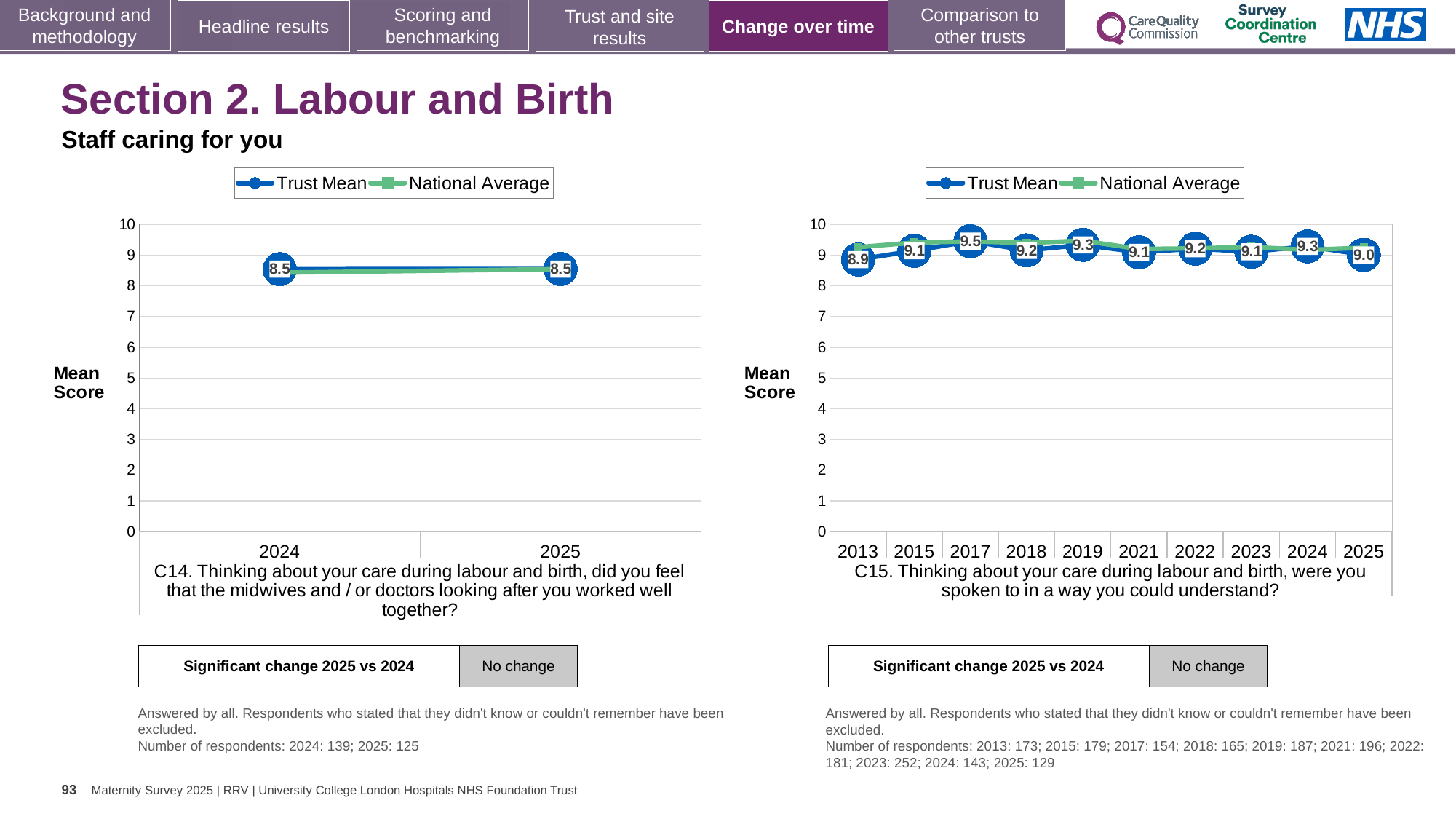
In the right chart (C15), what is the difference between the Trust Mean scores for 2017 and 2013? 0.6 In the right chart (C15), is the Trust Mean score for 2019 larger or smaller than the score for 2021? larger In the left chart (C14), what is the Trust Mean score for 2025? 8.5 In the left chart (C14), is the National Average value for 2025 greater or less than 8? greater In the right chart (C15), which year has the lowest Trust Mean score? 2013 In the right chart (C15), what is the Trust Mean score for 2025? 9.0 How many years are shown on the x axis of the right chart (C15)? 10 In the right chart (C15), which year has the highest Trust Mean score? 2017 How many series does the legend of the left chart (C14) list? 2 What type of chart is the right chart (C15)? Line chart In the right chart (C15), what is the Trust Mean score for 2017? 9.5 In the left chart (C14), what is the Trust Mean score for 2024? 8.5